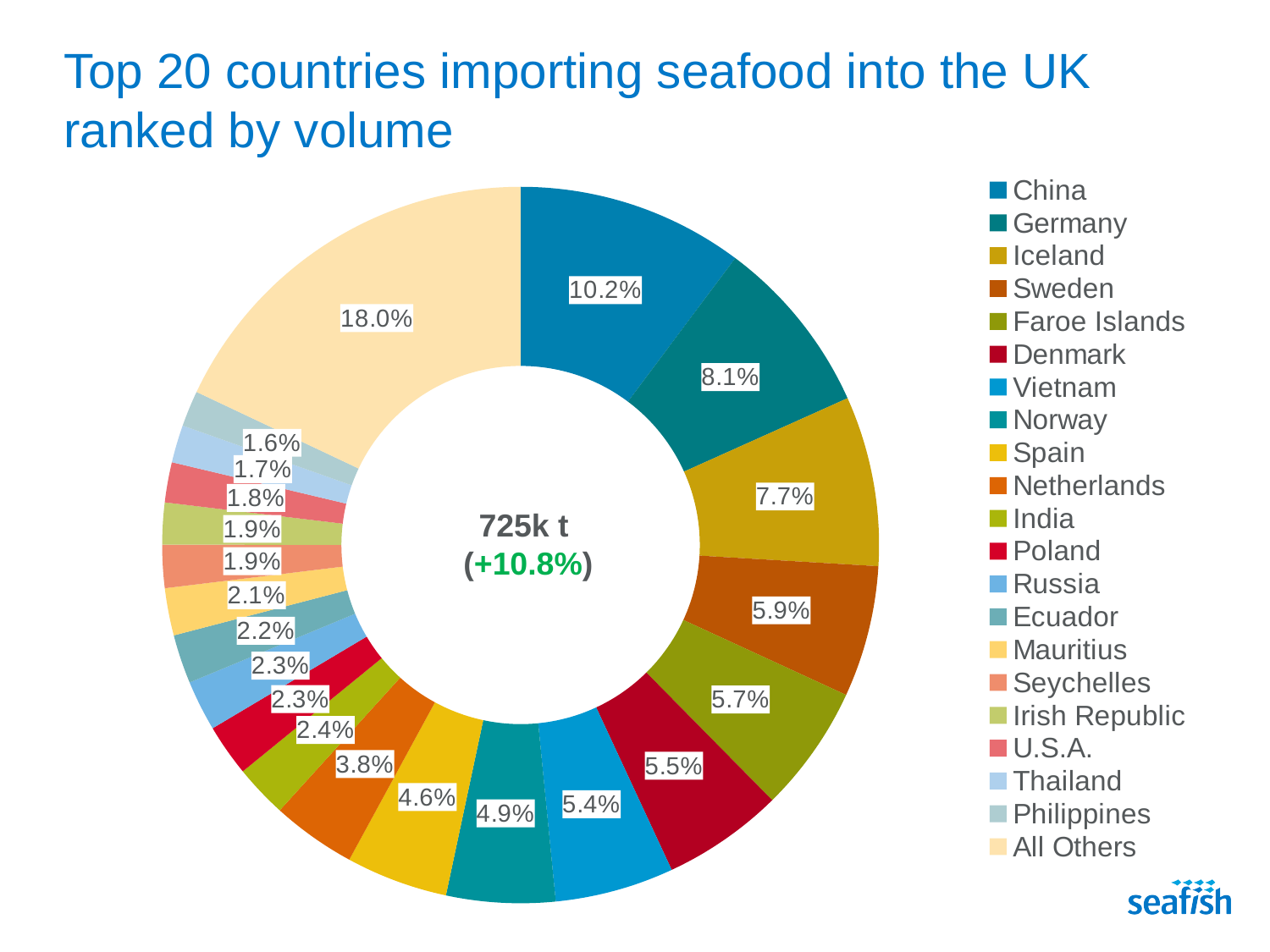
What total volume is shown in the centre of the doughnut? 725k t What percentage is shown for Iceland? 7.7% What share of UK seafood import volume does China account for? 10.2% What percentage is shown for Germany? 8.1% Which single named country has the largest share of the pie? China What kind of chart is shown on the slide? Pie chart (doughnut) Which country has the smallest share shown on the chart? Philippines What is the difference in percentage points between China's share and Germany's share? 2.1 What percentage change is shown in the centre of the chart? +10.8% How many entries does the legend list? 21 Which has the larger share, Sweden or Faroe Islands? Sweden What share is labelled for the All Others slice? 18.0%